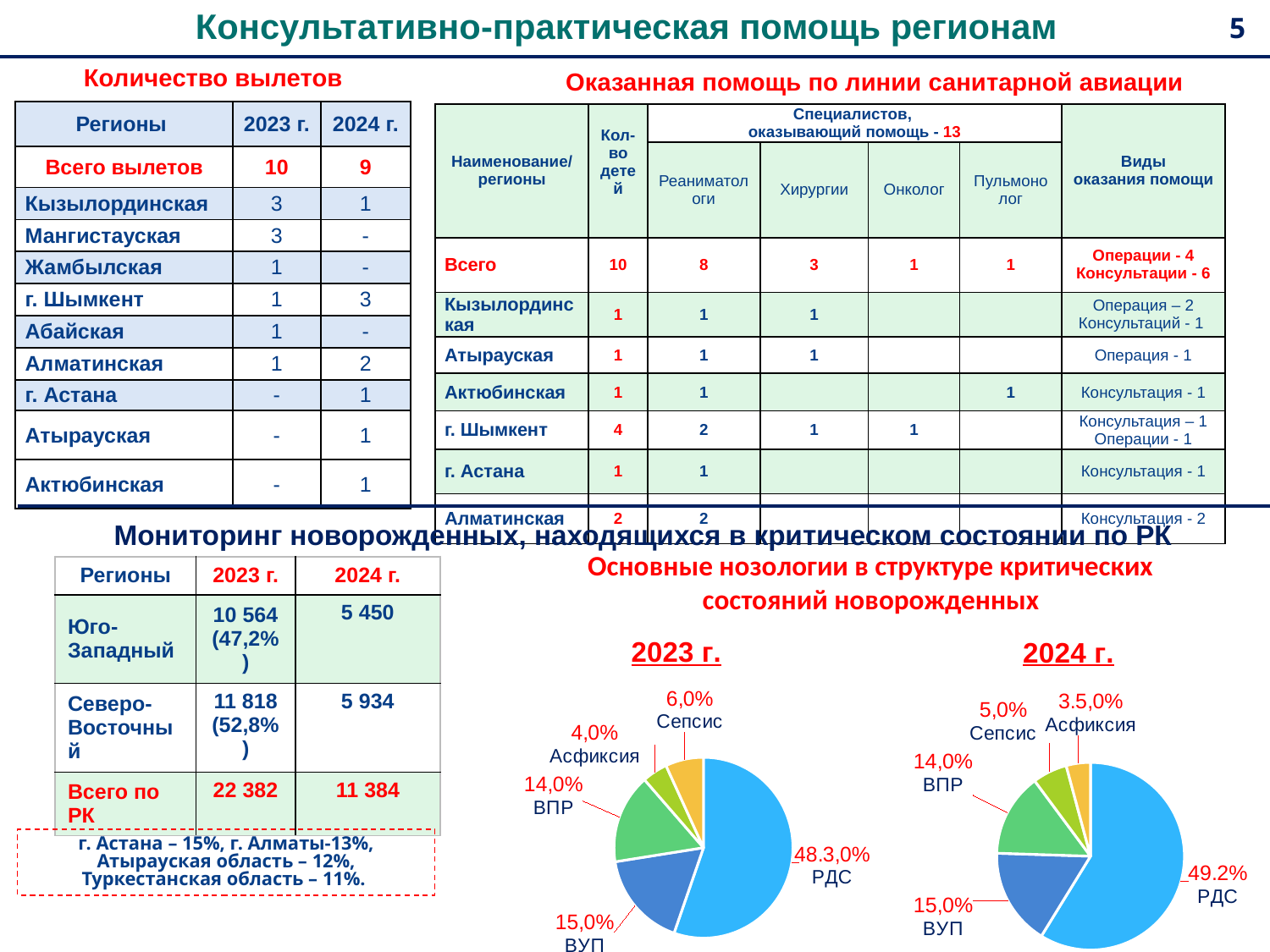
In the 2023 г. pie chart, which category has the smallest slice? Асфиксия In the 2023 г. pie chart, which category has the largest slice? РДС In the 2024 г. pie chart, what share is shown for ВПР? 14,0% In the 2024 г. pie chart, what share is shown for РДС? 49.2% How many slices does the 2024 г. pie chart have? 5 In the 2024 г. pie chart, which category has the smallest slice? Асфиксия What type of chart is used for the 2023 г. and 2024 г. nosology data? Pie chart What is the difference between the Сепсис share in the 2023 г. pie chart and in the 2024 г. pie chart? 1,0% In the 2023 г. pie chart, what share is shown for ВУП? 15,0% In the 2023 г. pie chart, which is larger: ВУП or Сепсис? ВУП In the 2024 г. pie chart, what share is shown for Сепсис? 5,0% In the 2023 г. pie chart, what share is shown for Сепсис? 6,0%